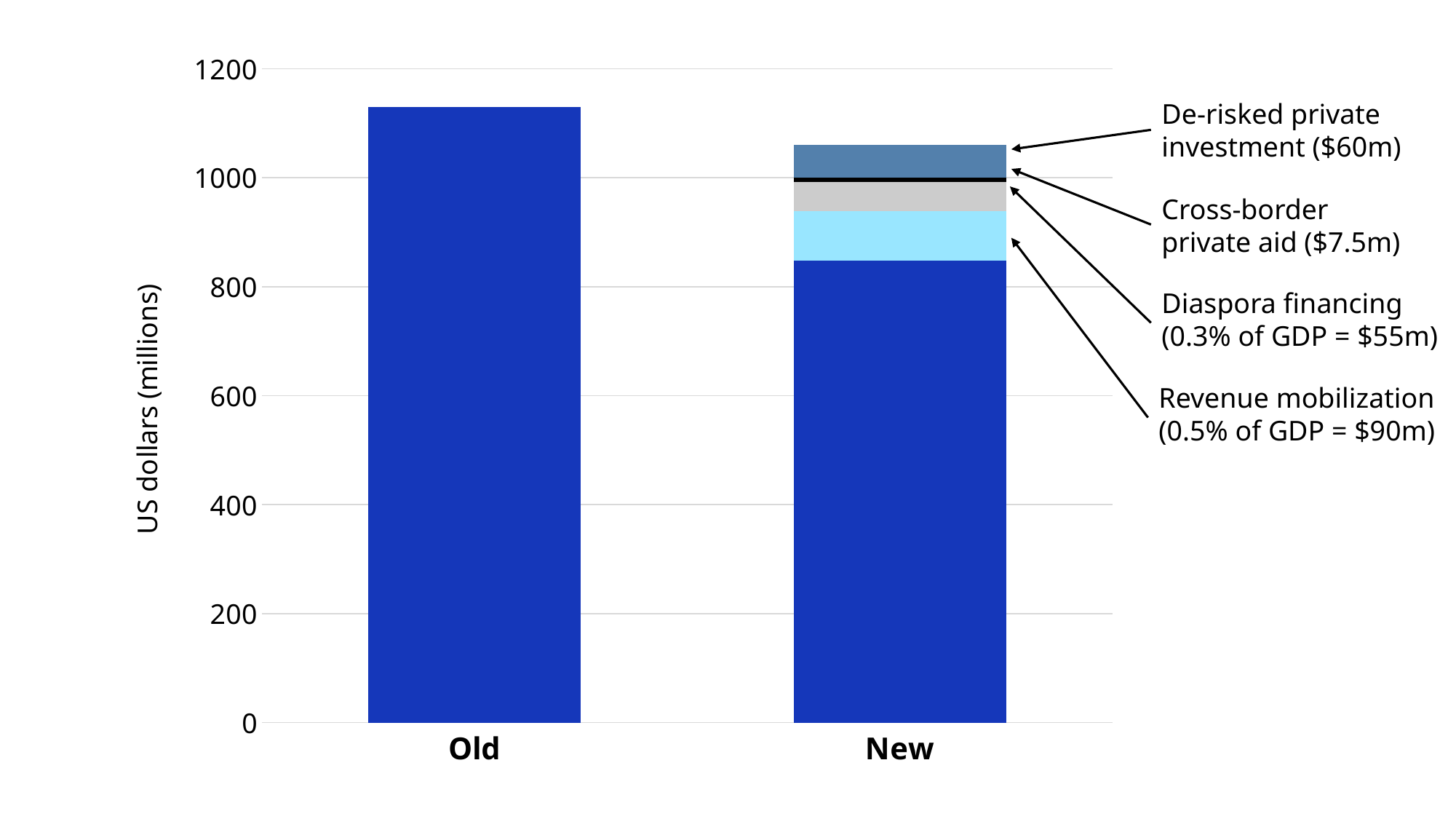
What is the label of the y axis? US dollars (millions) What value is given for Diaspora financing in the New bar? $55m What value is given for Revenue mobilization in the New bar? $90m What value is given for Cross-border private aid in the New bar? $7.5m What value is given for De-risked private investment in the New bar? $60m Is the total height of the New bar greater or less than 1200? less What is the difference between the De-risked private investment value and the Diaspora financing value? $5m Which of the four annotated components of the New bar has the smallest value? Cross-border private aid What kind of chart is shown on the slide? Stacked bar chart How many categories are shown on the x axis? 2 Which bar is taller, Old or New? Old Is the value of the Old bar greater or less than 1000? greater